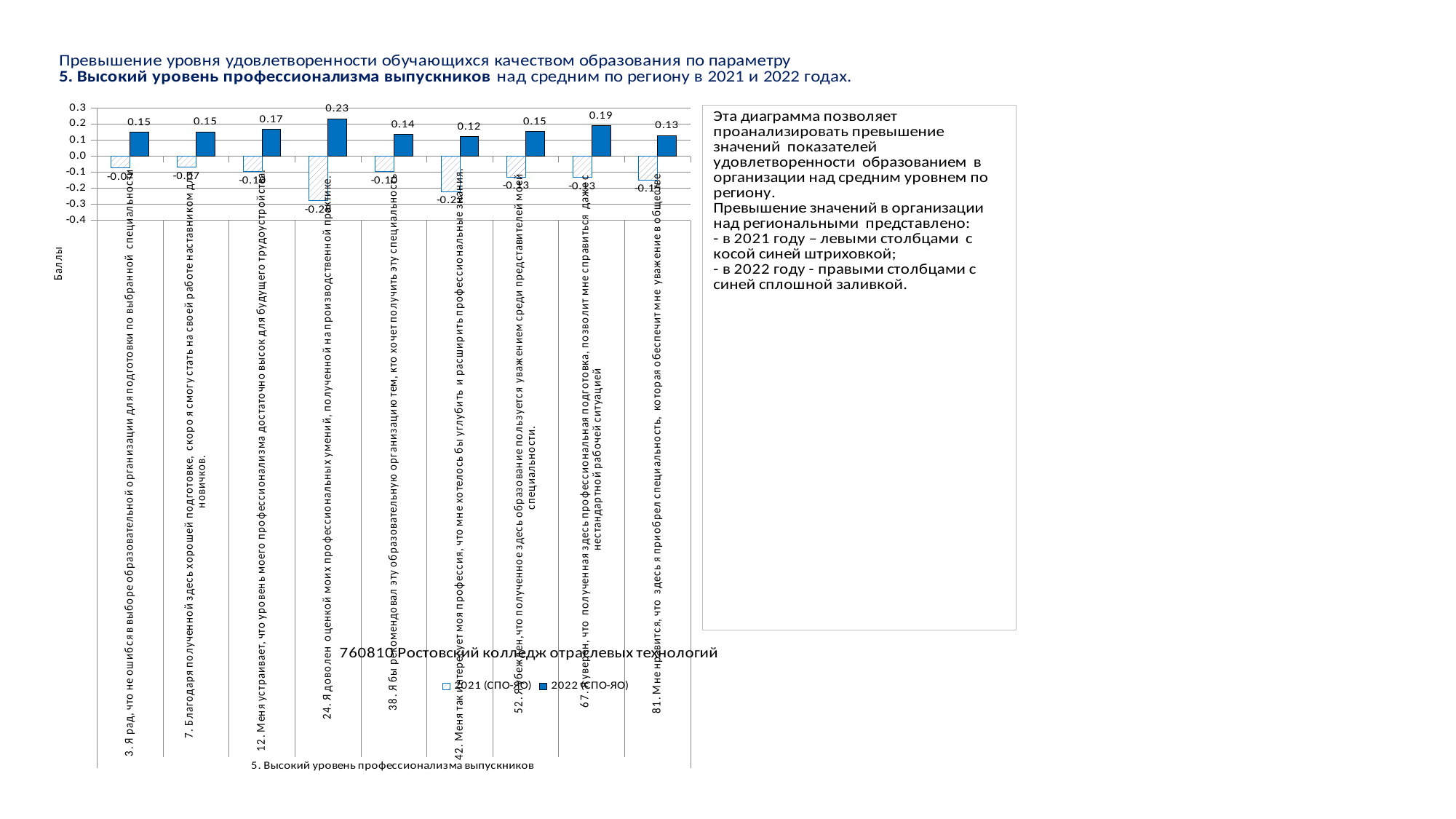
What is the 2021 (СПО-ЯО) value for statement 24? -0.28 Is the 2021 (СПО-ЯО) value for statement 42 greater or less than -0.2? less Which statement has the lowest 2022 (СПО-ЯО) value? 42. Меня так интересует моя профессия, что мне хотелось бы углубить и расширить профессиональные знания How many series does the legend list? 2 What is the 2022 (СПО-ЯО) value for statement 24 (Я доволен оценкой моих профессиональных умений...)? 0.23 What is the 2022 (СПО-ЯО) value for statement 67 (Я уверен, что полученная здесь профессиональная подготовка...)? 0.19 What are the two legend entries of the chart? 2021 (СПО-ЯО) and 2022 (СПО-ЯО) Which statement has the highest 2022 (СПО-ЯО) value? 24. Я доволен оценкой моих профессиональных умений, полученной на производственной практике How many categories (statements) are plotted on the x axis? 9 What is the difference between the 2022 (СПО-ЯО) values for statement 24 and statement 42? 0.11 What kind of chart is shown on the slide? bar chart Which has the larger 2022 (СПО-ЯО) value: statement 67 or statement 81? statement 67